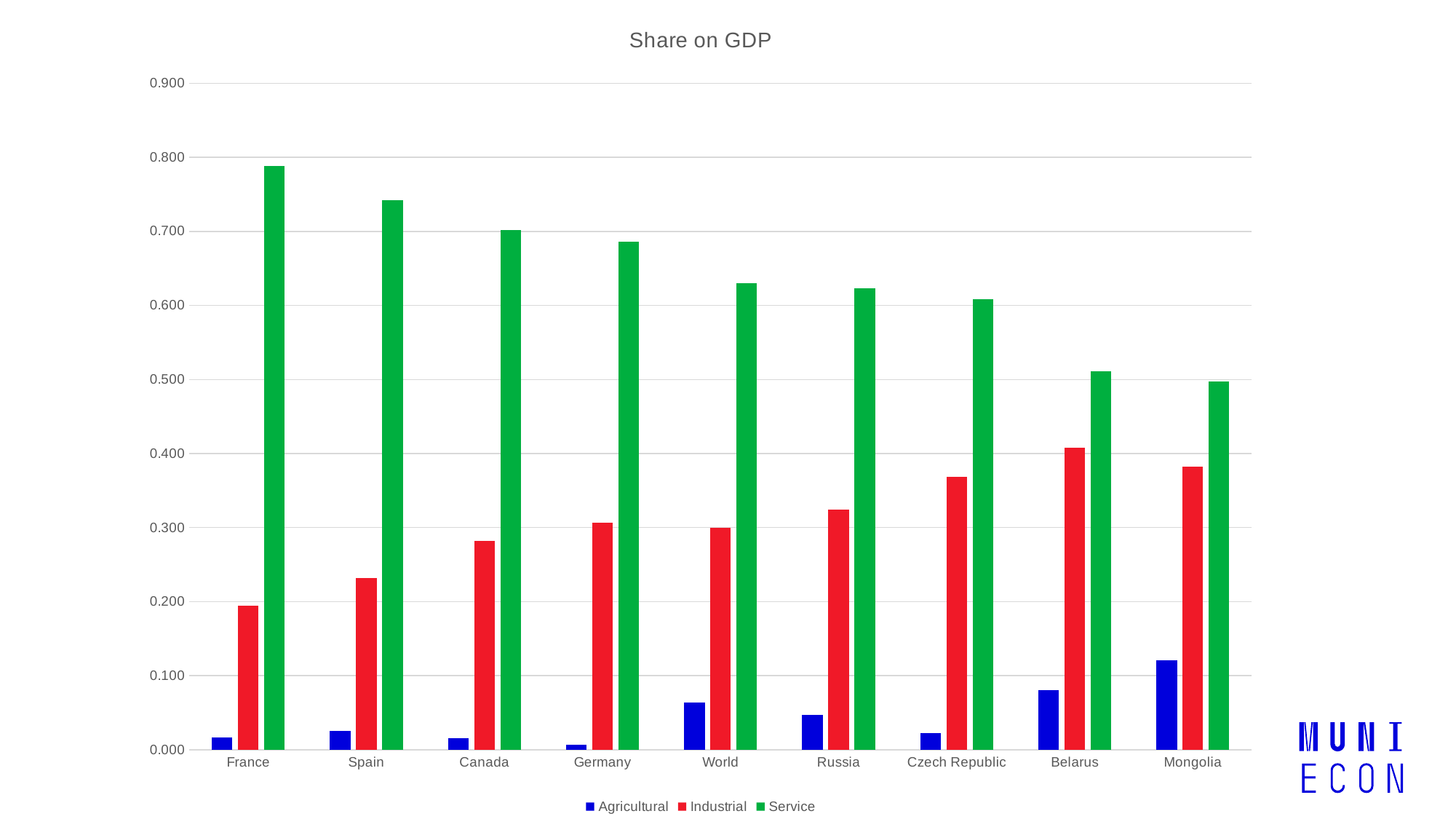
Which category has the highest Service share? France What kind of chart is shown on the slide? bar chart How many countries/categories are shown on the x axis? 9 Is the Industrial value for Czech Republic greater or less than 0.400? less Is the Service value for France greater or less than 0.700? greater Which category has the lowest Agricultural share? Germany Is the Agricultural value for Mongolia greater or less than 0.100? greater Do the Service values rise or fall moving from France to Mongolia along the x axis? fall Which category has the highest Industrial share? Belarus Which is larger, the Service share for Spain or for Canada? Spain Which category has the highest Agricultural share? Mongolia How many series does the legend list? 3